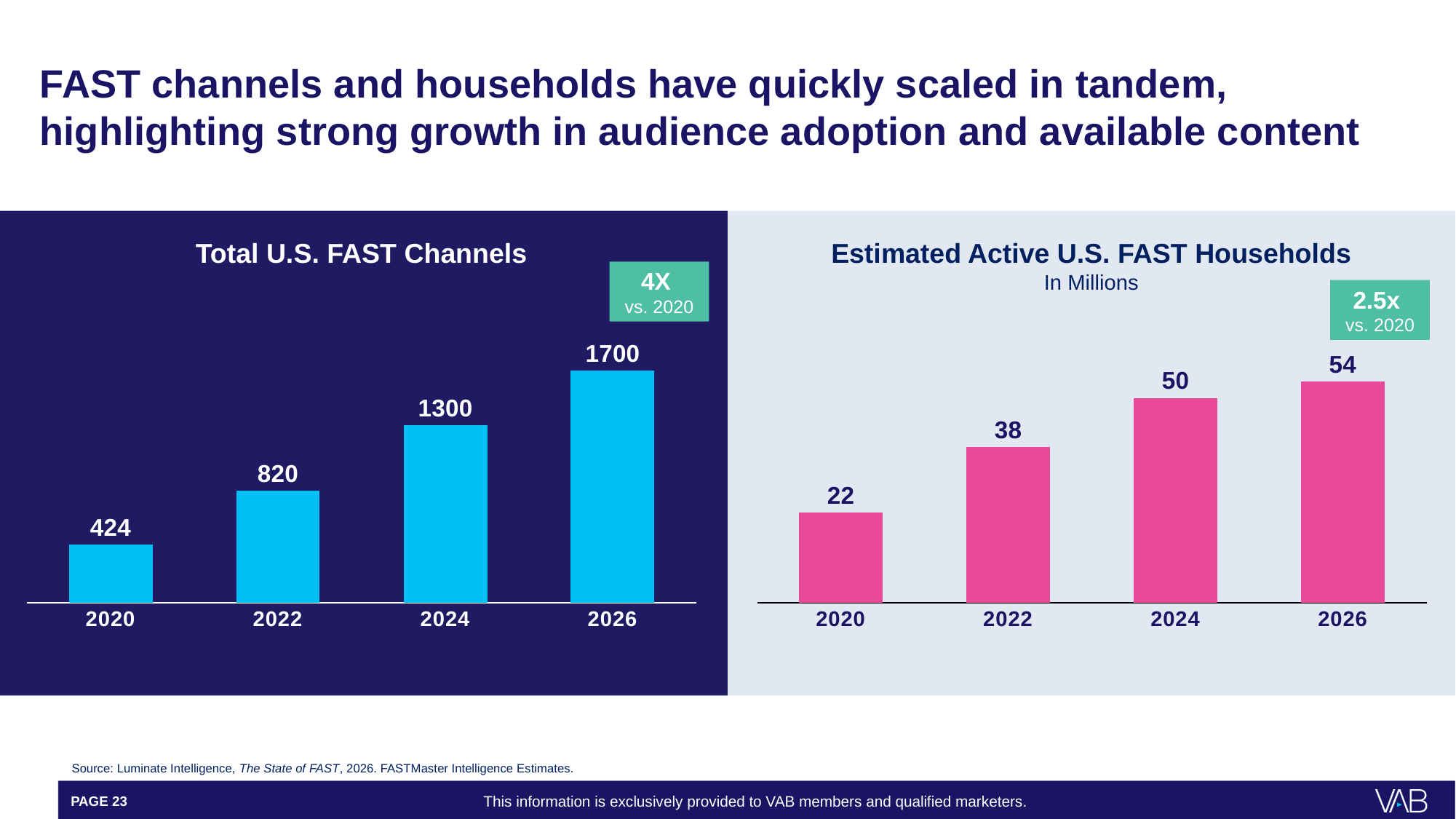
What kind of chart is the 'Total U.S. FAST Channels' chart? Bar chart In the 'Total U.S. FAST Channels' chart, which year has the highest value? 2026 In the 'Estimated Active U.S. FAST Households' chart, do the values rise or fall from 2020 to 2026? Rise In the 'Total U.S. FAST Channels' chart, what is the difference between the 2026 and 2020 values? 1276 What growth multiple vs. 2020 is shown in the callout box on the 'Total U.S. FAST Channels' chart? 4X In the 'Estimated Active U.S. FAST Households' chart, which year has the lowest value? 2020 In the 'Total U.S. FAST Channels' chart, what is the value for 2022? 820 In the 'Estimated Active U.S. FAST Households' chart, what is the difference between the 2022 and 2020 values? 16 In the 'Total U.S. FAST Channels' chart, which is larger, the value for 2024 or the value for 2022? 2024 In the 'Estimated Active U.S. FAST Households' chart, what is the value for 2024? 50 What unit is stated under the title of the 'Estimated Active U.S. FAST Households' chart? In Millions How many years are shown on the x axis of the 'Estimated Active U.S. FAST Households' chart? 4